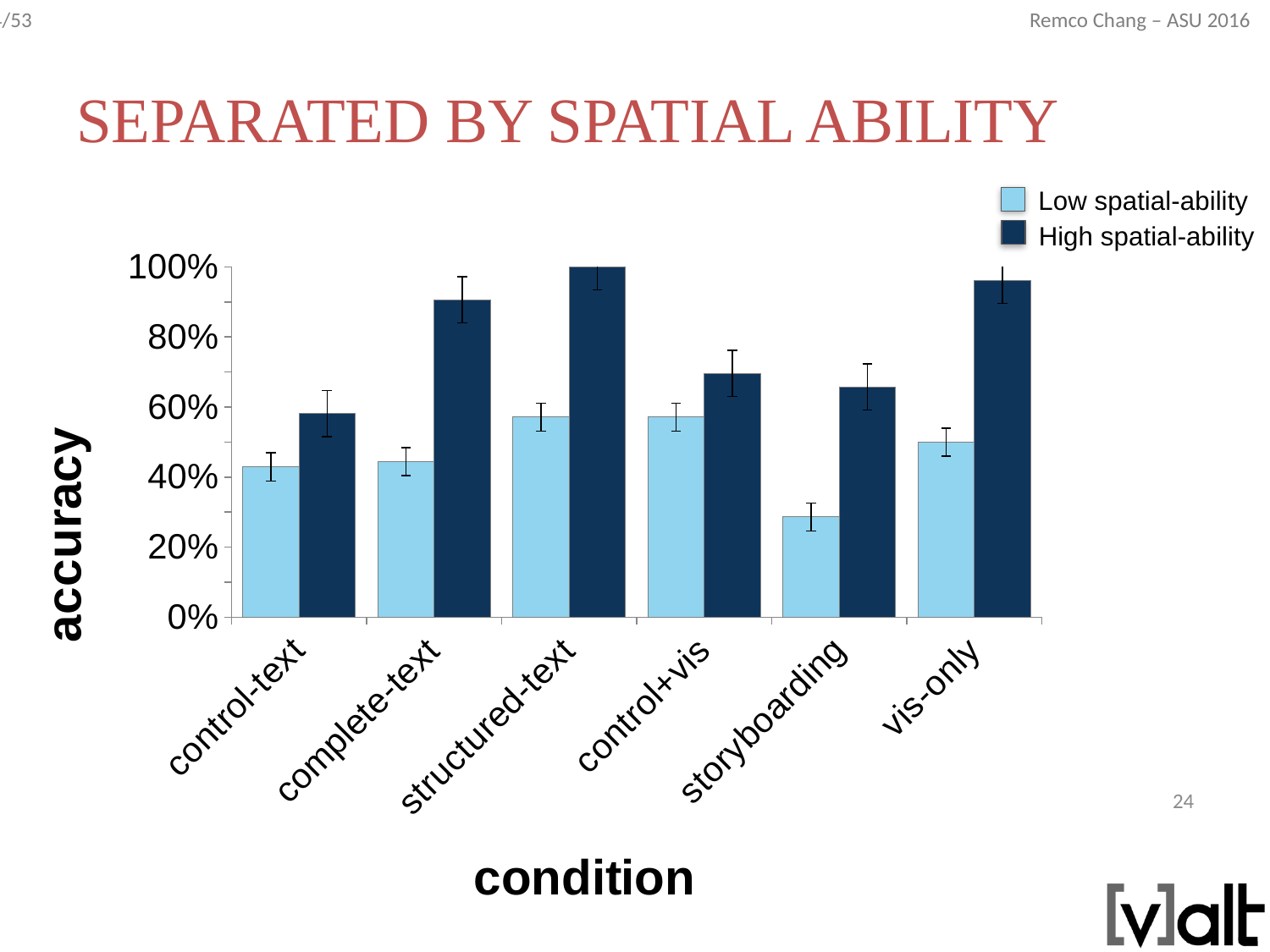
Which is larger: the High spatial-ability accuracy for complete-text or the High spatial-ability accuracy for control+vis? complete-text For the vis-only condition, which series has the higher accuracy, Low spatial-ability or High spatial-ability? High spatial-ability What kind of chart is shown on the slide? bar chart Is the High spatial-ability accuracy for control-text greater or less than 80%? less Which condition has the highest accuracy for the High spatial-ability series? structured-text Is the Low spatial-ability accuracy for storyboarding greater or less than 40%? less What is the label on the y axis of the chart? accuracy How many conditions are shown along the x axis? 6 Which condition has the lowest accuracy for the Low spatial-ability series? storyboarding Is the Low spatial-ability accuracy for control-text greater or less than 60%? less How many series does the legend list? 2